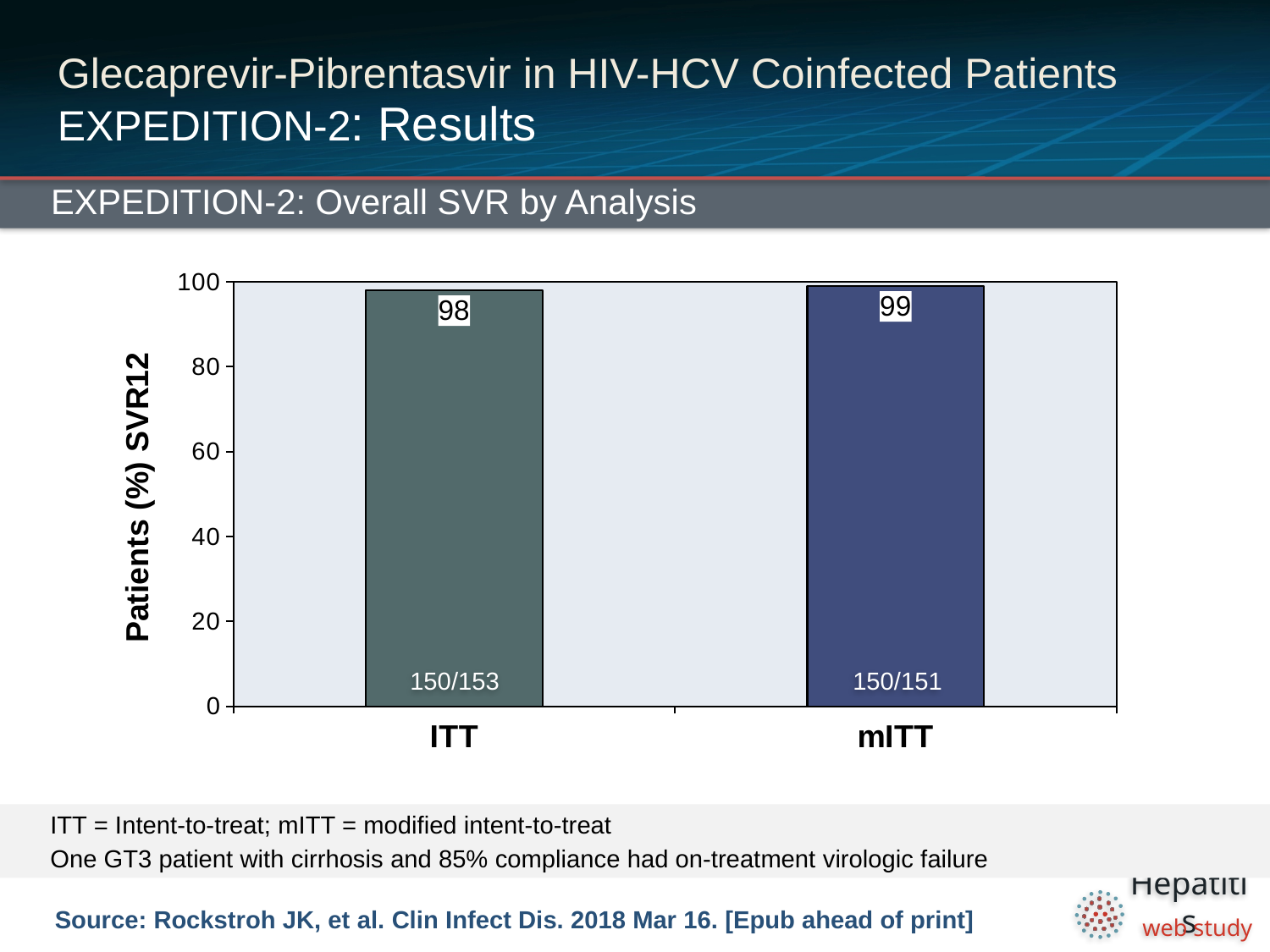
What kind of chart is shown on the slide? bar chart Which category has the lower SVR12 value? ITT What is the SVR12 value for mITT? 99 Which category has the higher SVR12 value? mITT What is the y-axis label of the chart? Patients (%) SVR12 Is the value for ITT greater or less than 80? greater What fraction of patients is printed on the mITT bar? 150/151 What fraction of patients is printed on the ITT bar? 150/153 What is the title of the chart? EXPEDITION-2: Overall SVR by Analysis What is the SVR12 value for ITT? 98 How many categories are shown on the x axis? 2 What is the difference between the mITT and ITT SVR12 values? 1